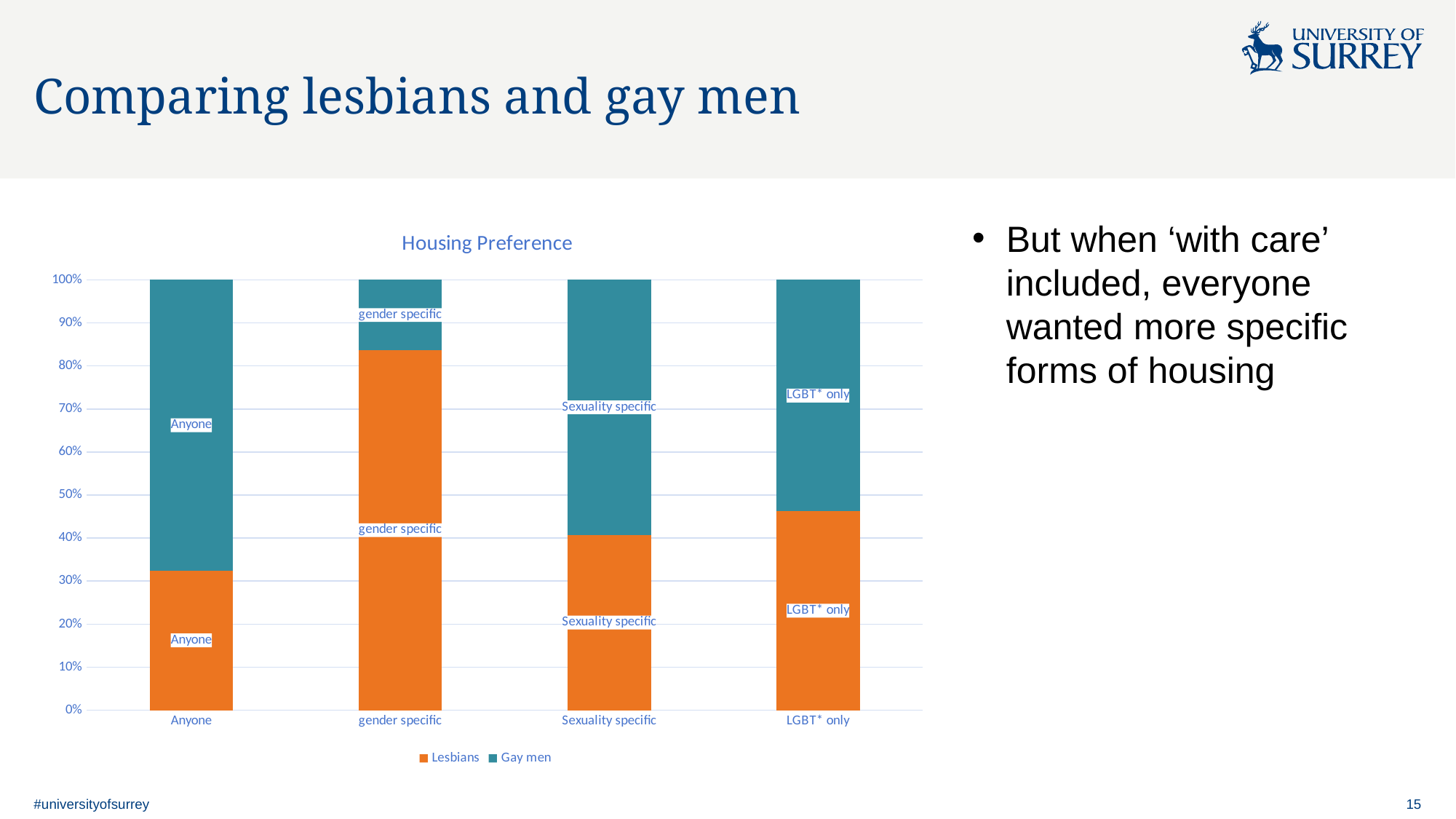
For which category is the Lesbians share of the bar the largest? gender specific How many series does the legend list? 2 What does each stacked bar total on the y axis? 100% For which category is the Lesbians share of the bar the smallest? Anyone Is the Lesbians value for gender specific greater or less than 70%? greater Which series is shown in orange in the chart? Lesbians What kind of chart is shown on the slide? Stacked bar chart What is the title of the chart? Housing Preference Is the Lesbians value for Anyone greater or less than 40%? less How many housing preference categories are shown on the x axis? 4 Which is larger for Lesbians: the value for gender specific or the value for Sexuality specific? gender specific Is the Gay men share of the Anyone bar greater or less than 60%? greater